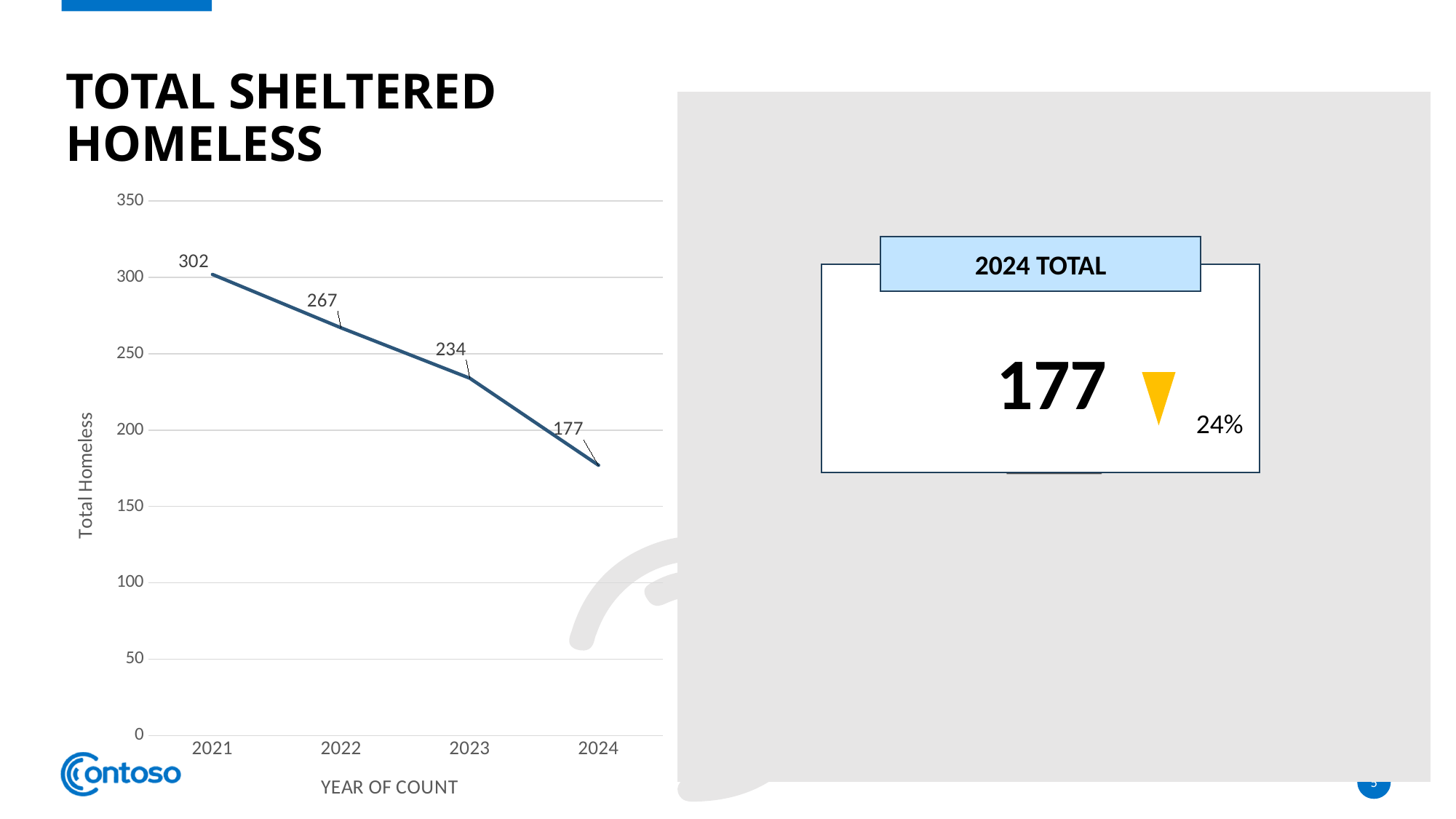
What is the total sheltered homeless value for 2021? 302 Which is larger, the value for 2022 or the value for 2023? 2022 What is the difference between the 2021 and 2024 values? 125 How many years are plotted on the chart? 4 What is the total sheltered homeless value for 2024? 177 What is the difference between the 2022 and 2023 values? 33 Do the values rise or fall from 2021 to 2024? fall Is the value for 2022 greater or less than 250? greater What is the total sheltered homeless value for 2023? 234 What kind of chart is shown on the slide? line chart Which year has the highest total sheltered homeless count? 2021 Which year has the lowest total sheltered homeless count? 2024